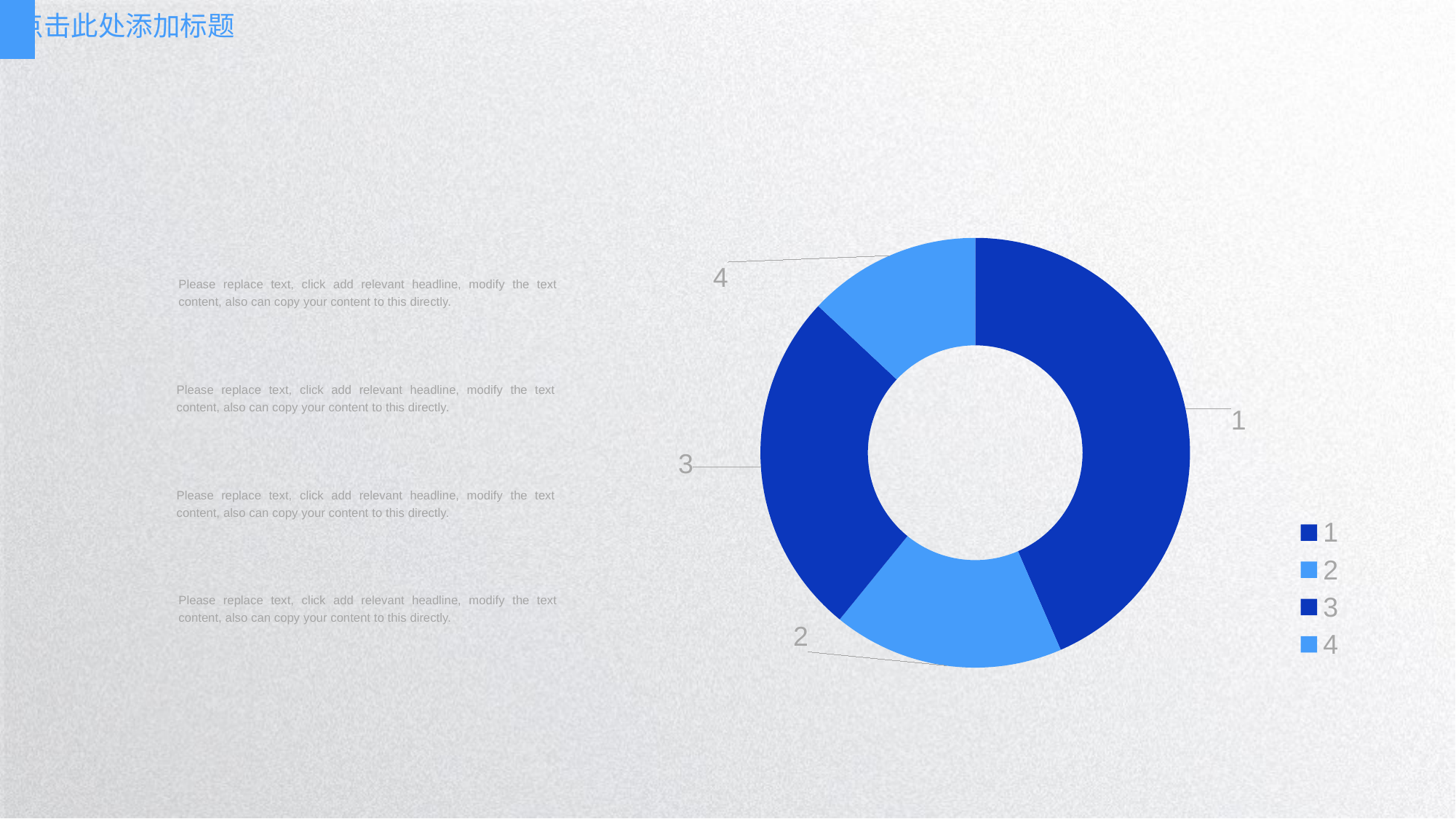
How many entries does the chart legend list? 4 How many slices does the doughnut chart have? 4 What kind of chart is shown on the slide? Doughnut chart Which slice of the doughnut chart is the smallest? 4 Which slice is larger, slice 3 or slice 2? 3 Which slice is larger, slice 1 or slice 2? 1 Which slice is positioned on the right side of the doughnut chart? 1 What are the labels listed in the chart legend? 1, 2, 3, 4 Which slice of the doughnut chart is the largest? 1 Which slice is larger, slice 1 or slice 3? 1